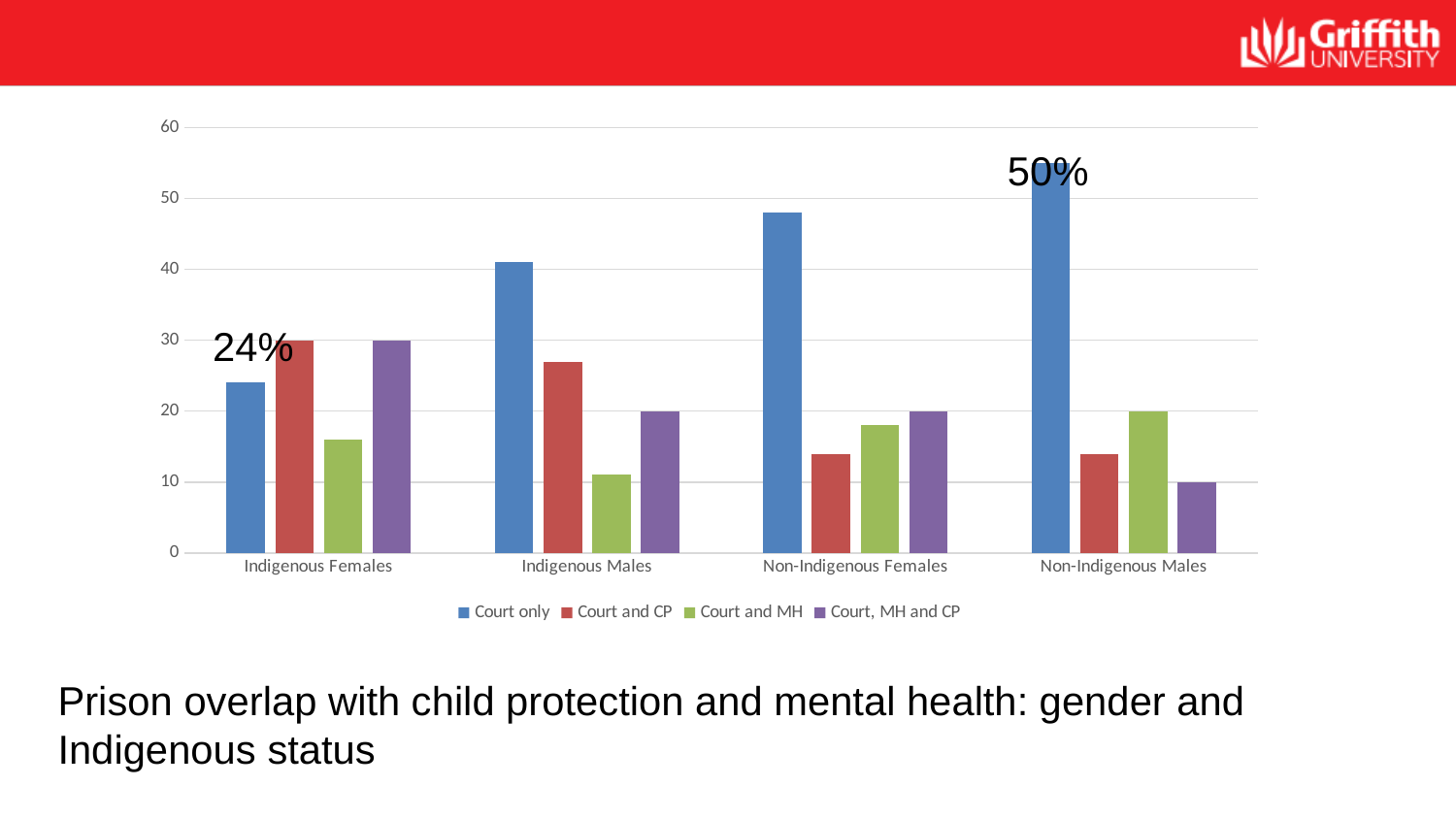
Which category has the lowest Court only bar? Indigenous Females Is the Court only value for Non-Indigenous Females greater or less than 40? greater Is the Court and MH value for Indigenous Males greater or less than 20? less Which category has the highest Court only bar? Non-Indigenous Males What is the labelled value for Court only for Non-Indigenous Males? 50% What is the labelled value for Court only for Indigenous Females? 24% How many series does the legend list? 4 Which is larger for Indigenous Females: Court and CP or Court and MH? Court and CP How many categories are shown on the x axis? 4 Which category has the lowest Court, MH and CP bar? Non-Indigenous Males What is the title text below the chart? Prison overlap with child protection and mental health: gender and Indigenous status What type of chart is shown on the slide? Bar chart